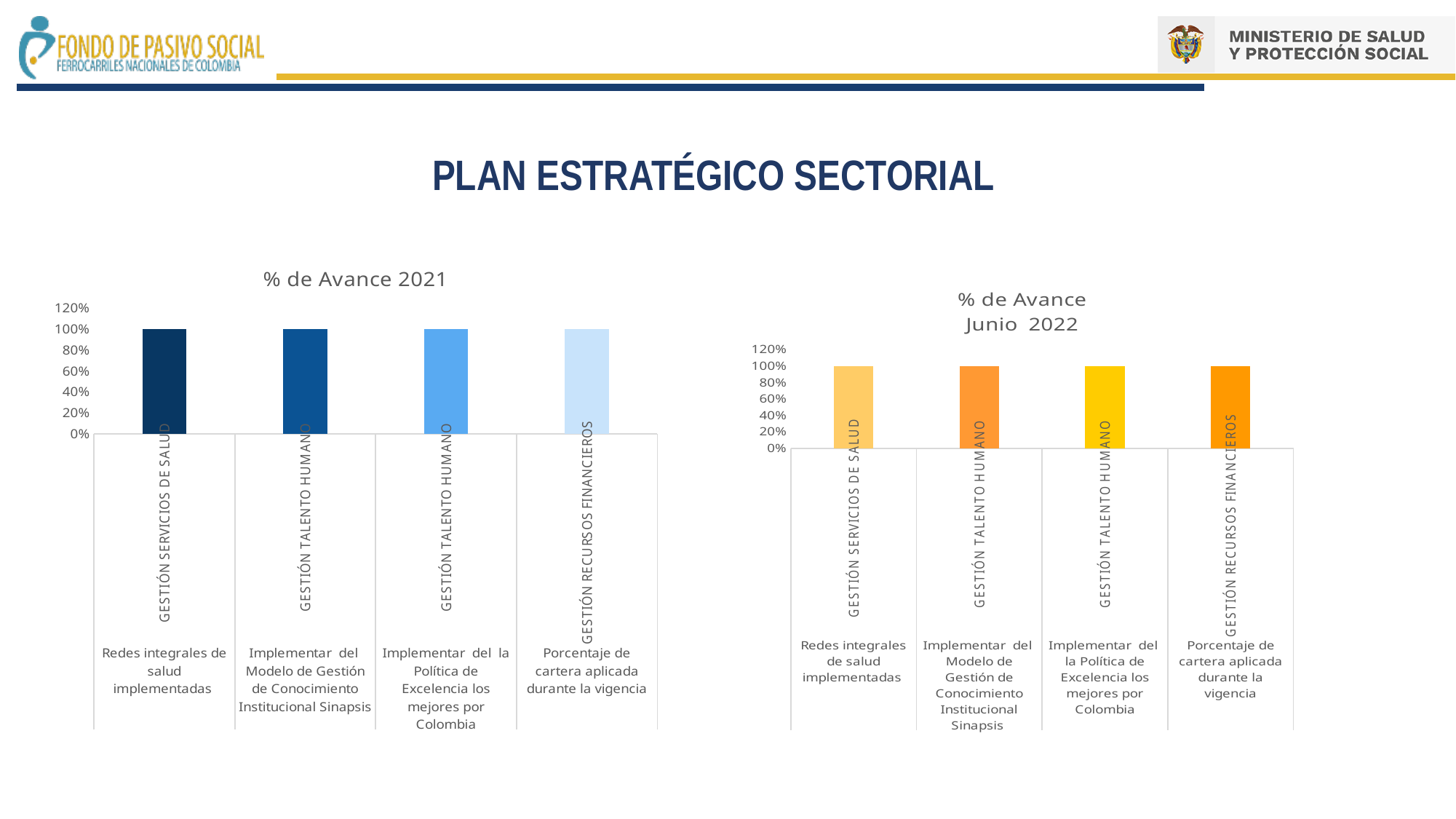
What kind of chart is the "% de Avance 2021" chart on the left? bar chart In the "% de Avance Junio 2022" chart, is the value for "Implementar del la Política de Excelencia los mejores por Colombia" greater or less than 120%? less What is the title of the chart on the right side of the slide? % de Avance Junio 2022 How many bars does the "% de Avance 2021" chart show? 4 In the "% de Avance 2021" chart, is the value for "Implementar del Modelo de Gestión de Conocimiento Institucional Sinapsis" greater or less than 80%? greater In the "% de Avance 2021" chart, what is the difference between the value for "Redes integrales de salud implementadas" and the value for "Porcentaje de cartera aplicada durante la vigencia"? 0% How many bars does the "% de Avance Junio 2022" chart show? 4 What is the highest value shown on the vertical axis of the "% de Avance 2021" chart? 120% In the "% de Avance Junio 2022" chart, do the values rise, fall, or stay the same across the categories? stay the same In the "% de Avance 2021" chart, what is the value for "Redes integrales de salud implementadas"? 100% In the "% de Avance Junio 2022" chart, what is the value for "Porcentaje de cartera aplicada durante la vigencia"? 100%